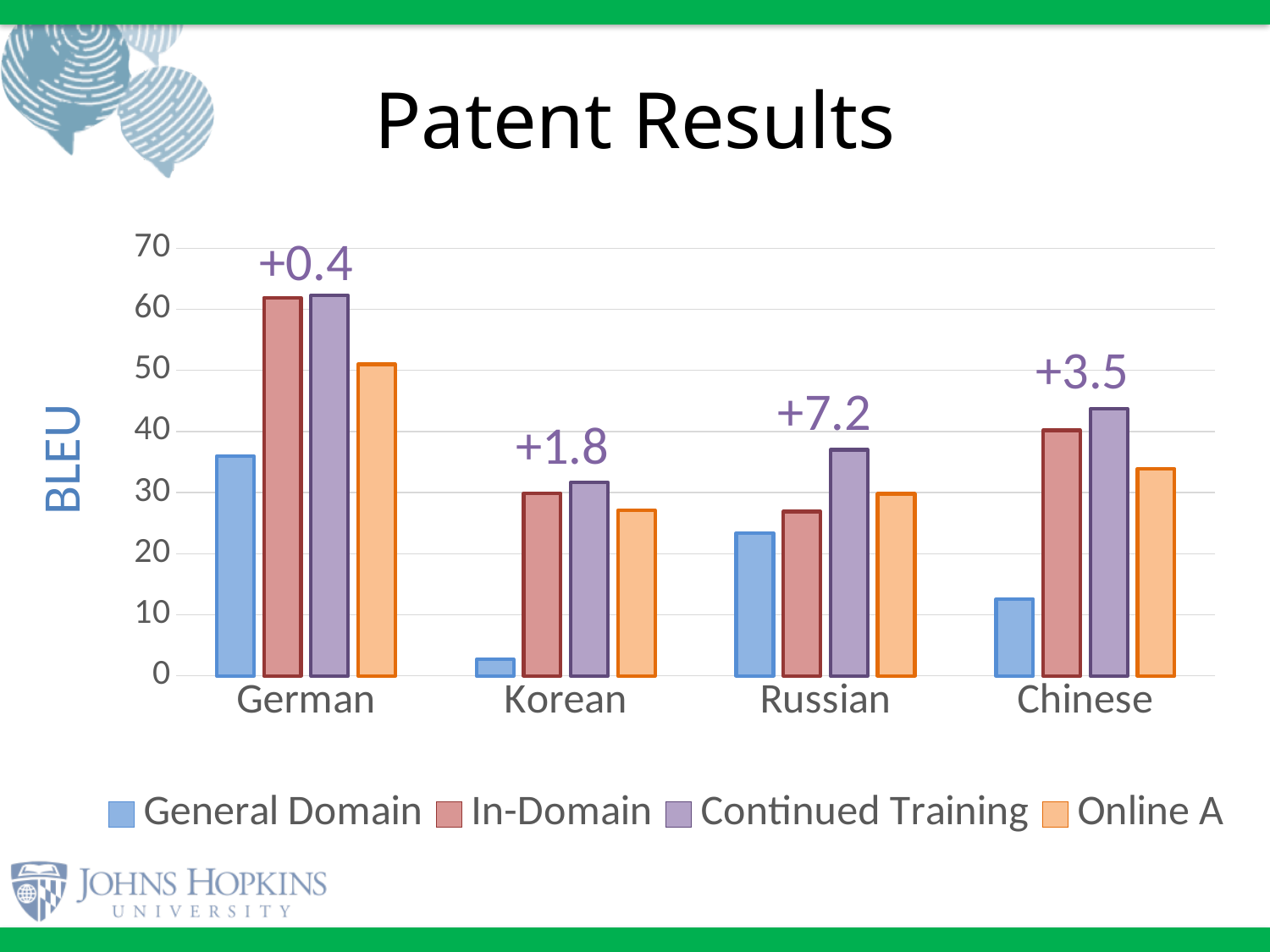
Is the General Domain value for Korean greater or less than 10? less What improvement value is annotated above the German group? +0.4 Which language has the highest Continued Training bar? German How many series does the legend list? 4 Which language has the smallest annotated improvement? German Is the Continued Training value for Russian greater or less than 30? greater What is the title of the chart? Patent Results For Russian, which is larger: Continued Training or Online A? Continued Training How many languages are shown on the x axis? 4 Which language has the largest annotated improvement? Russian What kind of chart is shown on the slide? bar chart What improvement value is annotated above the Russian group? +7.2